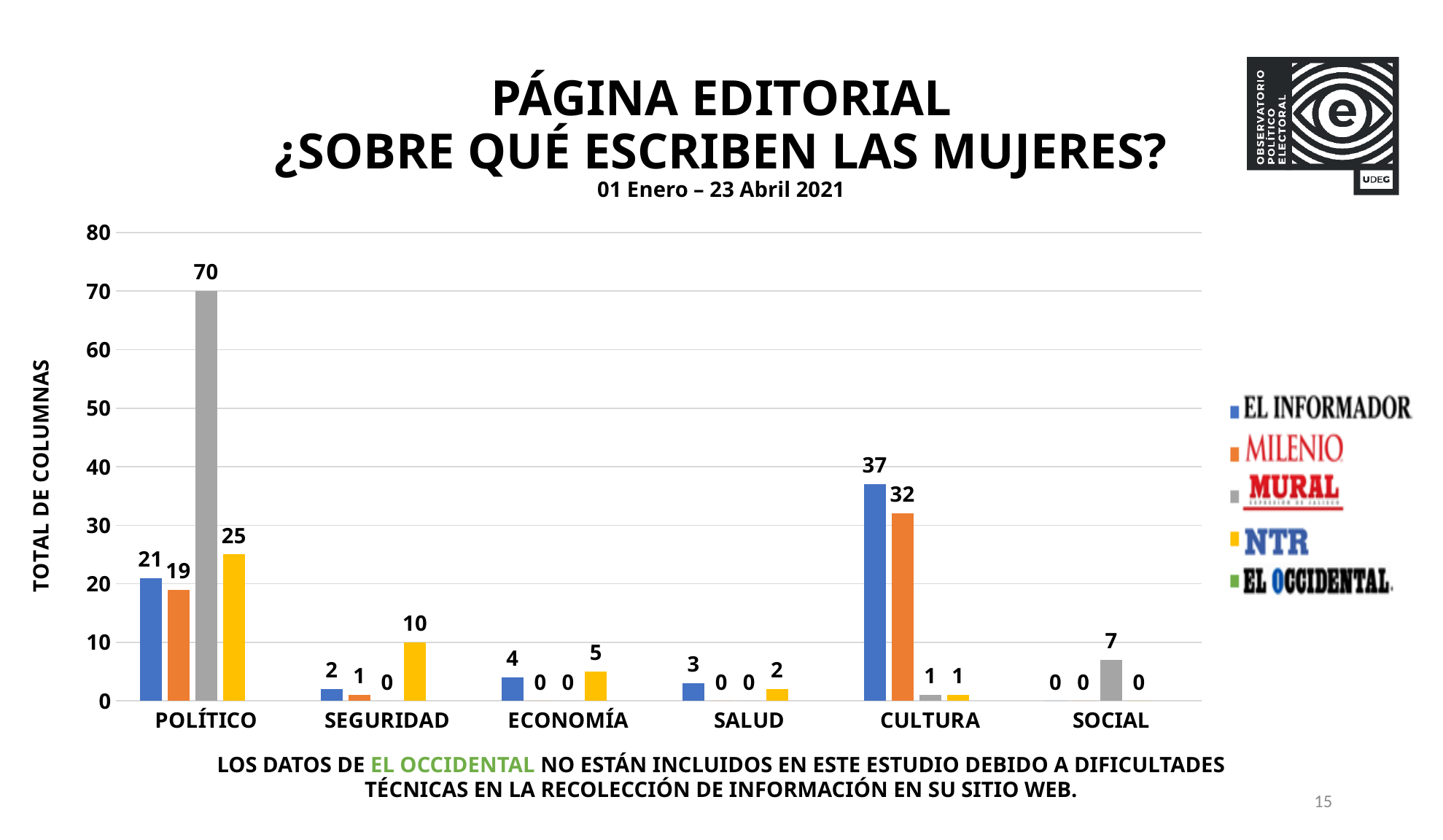
What is the difference between the MURAL and NTR values in the POLÍTICO category? 45 What is the value for MURAL in the POLÍTICO category? 70 What is the value for MURAL in the SOCIAL category? 7 Which category has the highest value for NTR? POLÍTICO Which category has the highest value for MILENIO? CULTURA What is the value for NTR in the SEGURIDAD category? 10 What is the difference between EL INFORMADOR and MILENIO in the CULTURA category? 5 Which is larger in the ECONOMÍA category, EL INFORMADOR or NTR? NTR How many series does the legend list? 5 How many categories are shown on the x axis? 6 What kind of chart is shown on the slide? Bar chart What is the value for EL INFORMADOR in the CULTURA category? 37